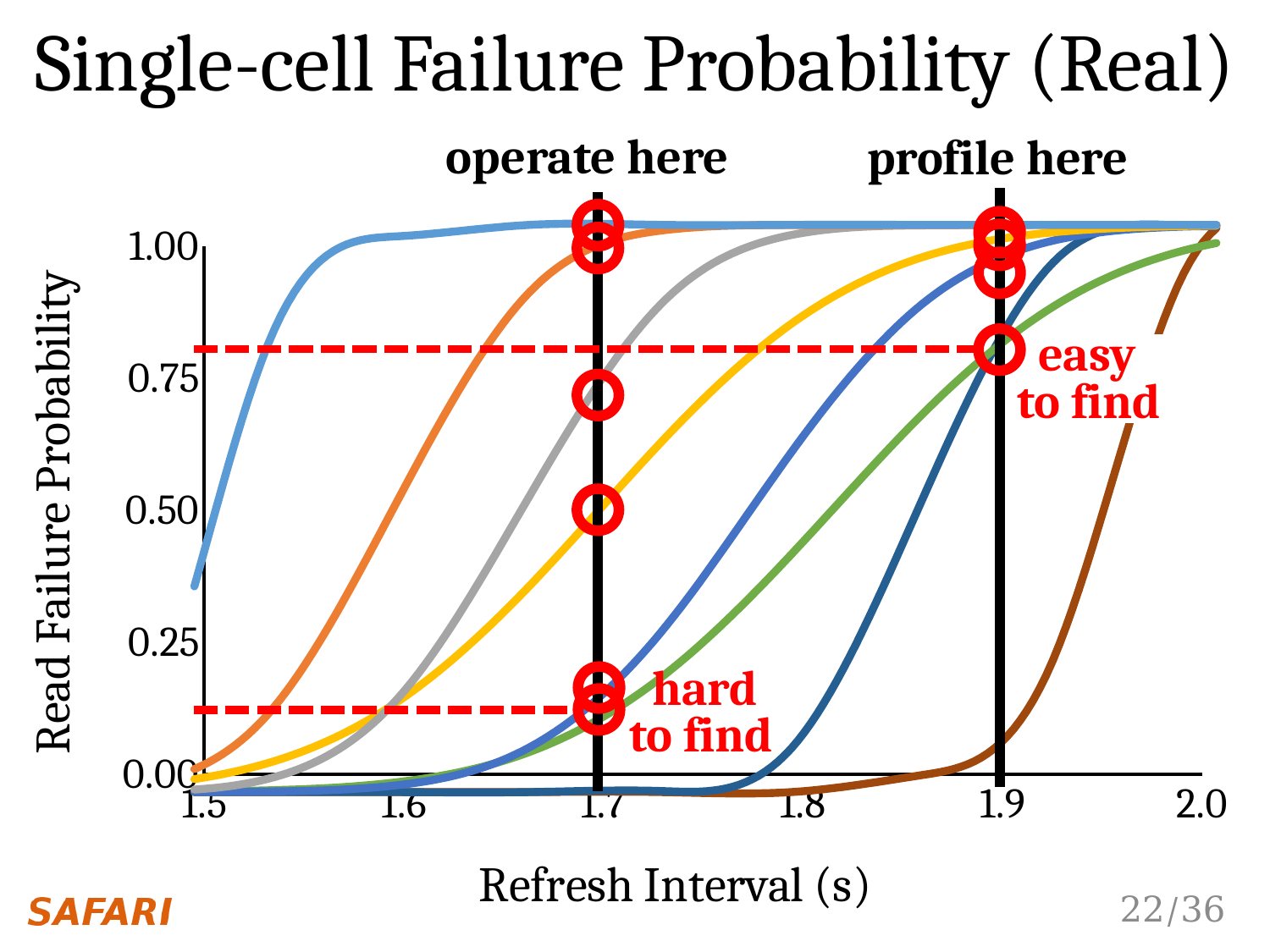
How many curves are plotted in the chart? 8 What type of chart is shown on the slide? Line chart Which curve reaches a read failure probability of 1.00 at the lowest refresh interval? The light blue curve At which refresh interval is the vertical line labeled "operate here" drawn? 1.7 At a refresh interval of 1.7 s, is the read failure probability of the dark blue curve greater or less than 0.25? less At a refresh interval of 1.9 s, is the read failure probability of the green curve greater or less than 0.50? greater Do the curves rise or fall as the refresh interval increases? Rise At a refresh interval of 1.7 s, is the read failure probability of the gray curve greater or less than 0.50? greater What is the title of the chart? Single-cell Failure Probability (Real) Which curve is the last to rise toward a read failure probability of 1.00? The brown curve